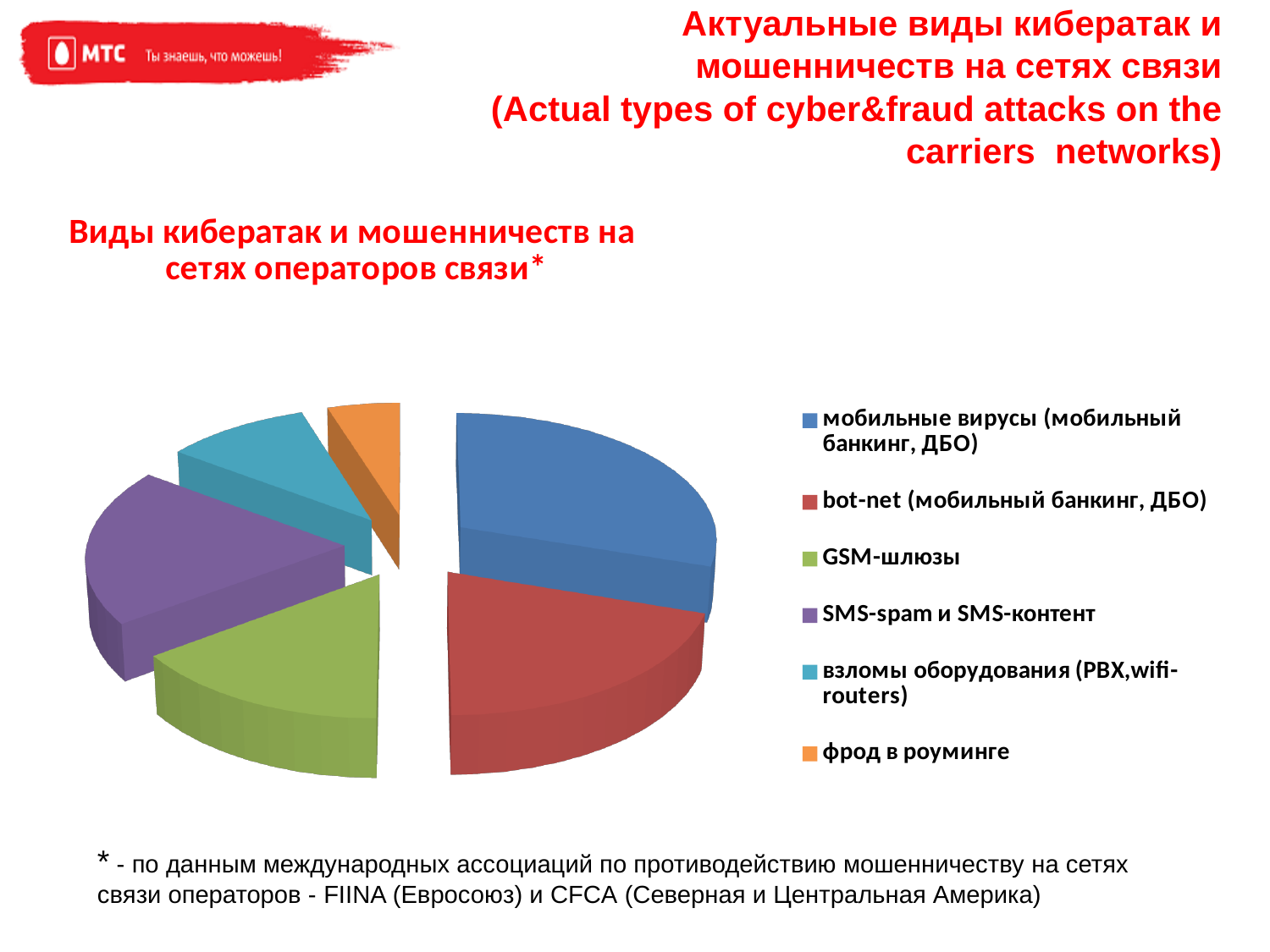
Which slice is larger: "GSM-шлюзы" or "фрод в роуминге"? GSM-шлюзы What colour is the "GSM-шлюзы" slice in the pie chart? green Which slice is larger: "фрод в роуминге" or "SMS-spam и SMS-контент"? SMS-spam и SMS-контент Which slice is larger: "взломы оборудования (PBX,wifi-routers)" or "SMS-spam и SMS-контент"? SMS-spam и SMS-контент Which category has the smallest slice in the pie chart? фрод в роуминге How many slices does the pie chart have? 6 What kind of chart is shown on the slide? pie chart What is the title of the pie chart? Виды кибератак и мошенничеств на сетях операторов связи* How many entries does the legend of the pie chart list? 6